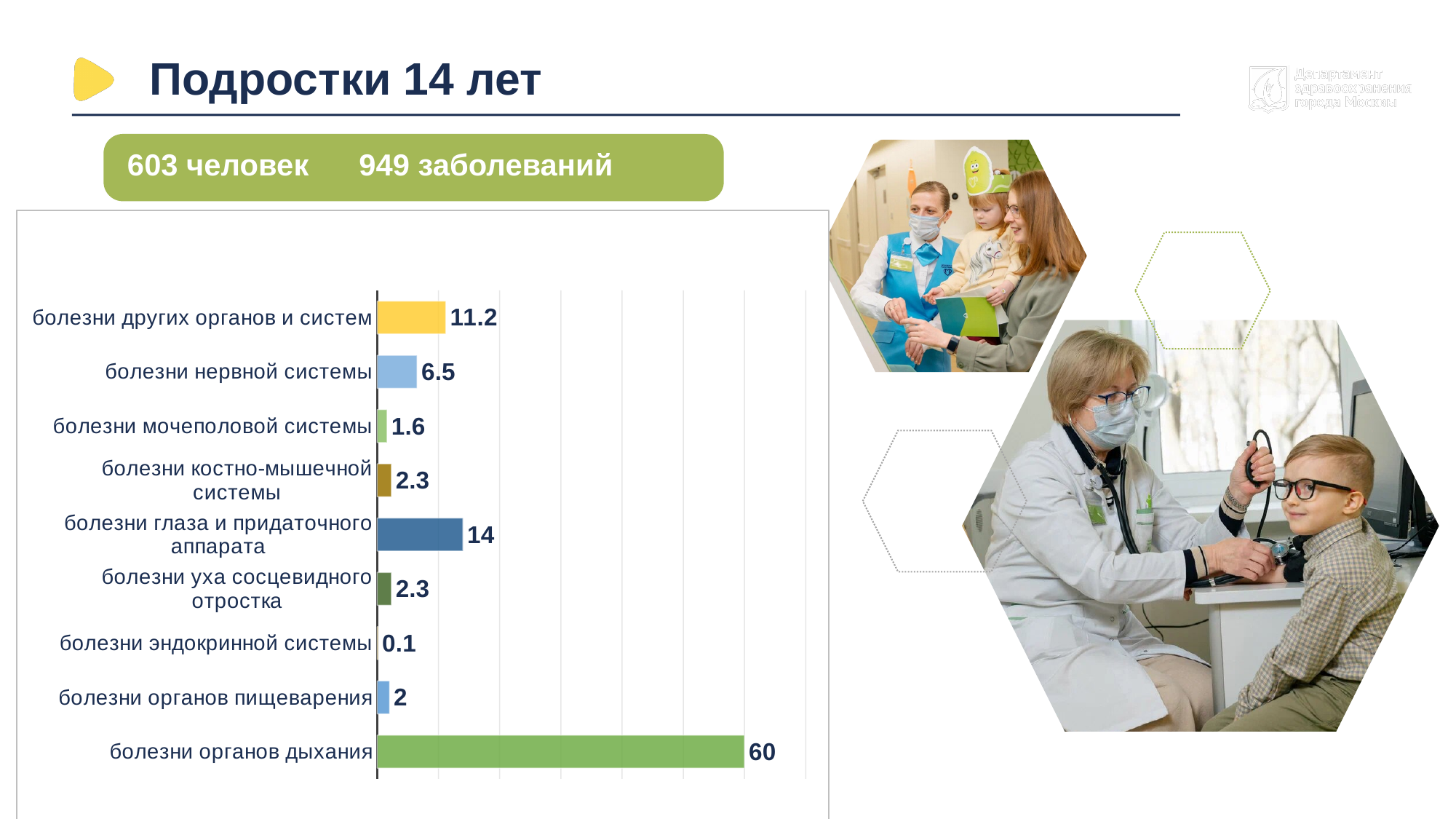
Which is larger: the value for болезни нервной системы or for болезни мочеполовой системы? болезни нервной системы Which category has the highest value? болезни органов дыхания What is the title of the slide? Подростки 14 лет What is the value for болезни органов дыхания? 60 What is the difference between the values for болезни органов дыхания and болезни глаза и придаточного аппарата? 46 What is the value for болезни нервной системы? 6.5 What is the value for болезни эндокринной системы? 0.1 What is the difference between the values for болезни других органов и систем and болезни нервной системы? 4.7 What kind of chart is shown on the slide? bar chart Which category has the lowest value? болезни эндокринной системы How many categories are shown in the chart? 9 What is the value for болезни глаза и придаточного аппарата? 14